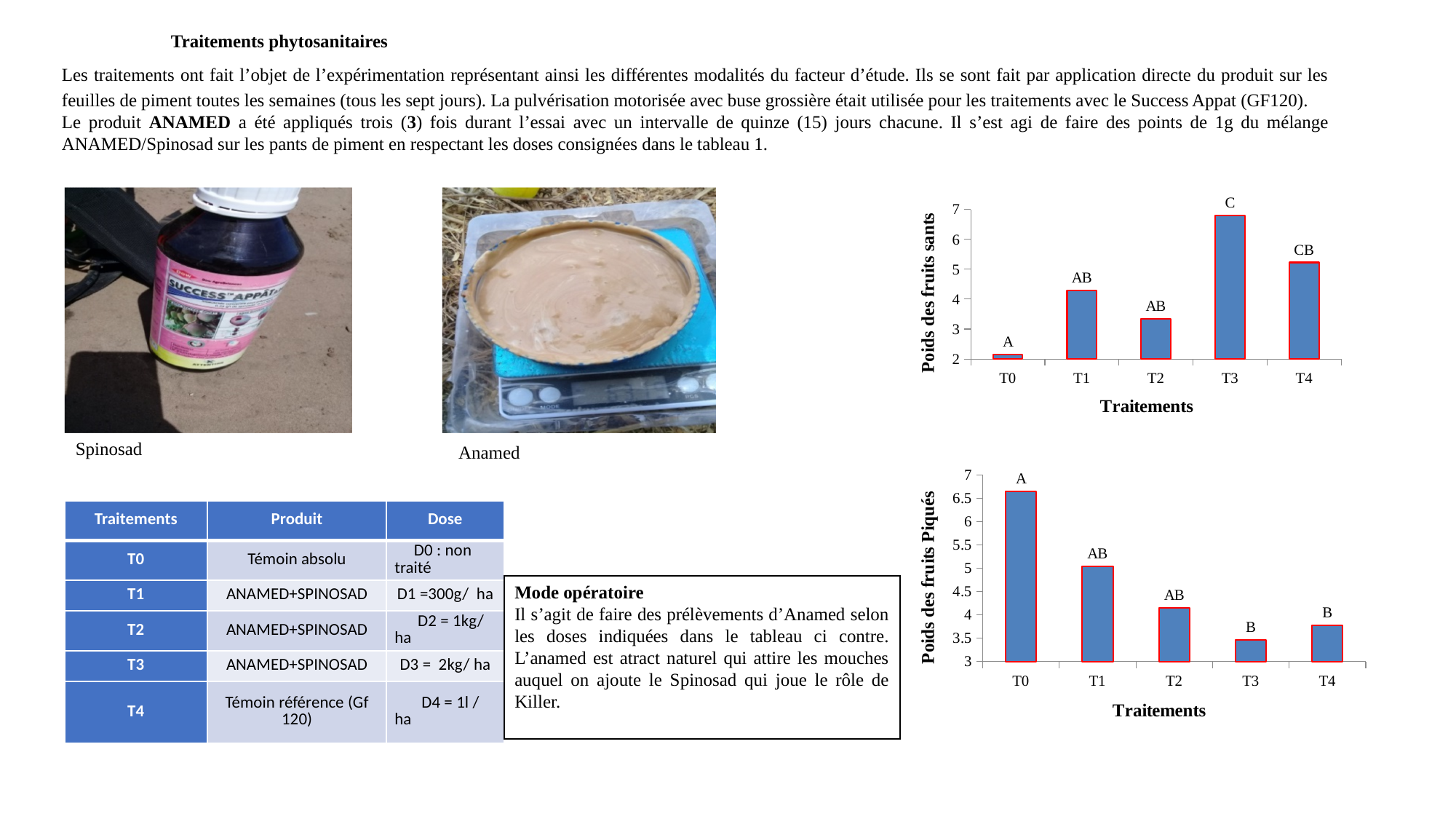
In the top-right chart (Poids des fruits sants), which is larger, the value for T1 or the value for T2? T1 In the top-right chart (Poids des fruits sants), which treatment has the highest value? T3 How many treatments are shown on the x axis of the top-right chart (Poids des fruits sants)? 5 In the bottom-right chart (Poids des fruits Piqués), which is larger, the value for T3 or the value for T4? T4 In the bottom-right chart (Poids des fruits Piqués), which treatment has the highest value? T0 What kind of chart is the bottom-right chart (Poids des fruits Piqués)? bar chart In the bottom-right chart (Poids des fruits Piqués), which treatment has the lowest value? T3 In the top-right chart (Poids des fruits sants), is the value for T2 greater or less than 4? less In the top-right chart (Poids des fruits sants), which treatment has the lowest value? T0 In the top-right chart (Poids des fruits sants), is the value for T3 greater or less than 6? greater